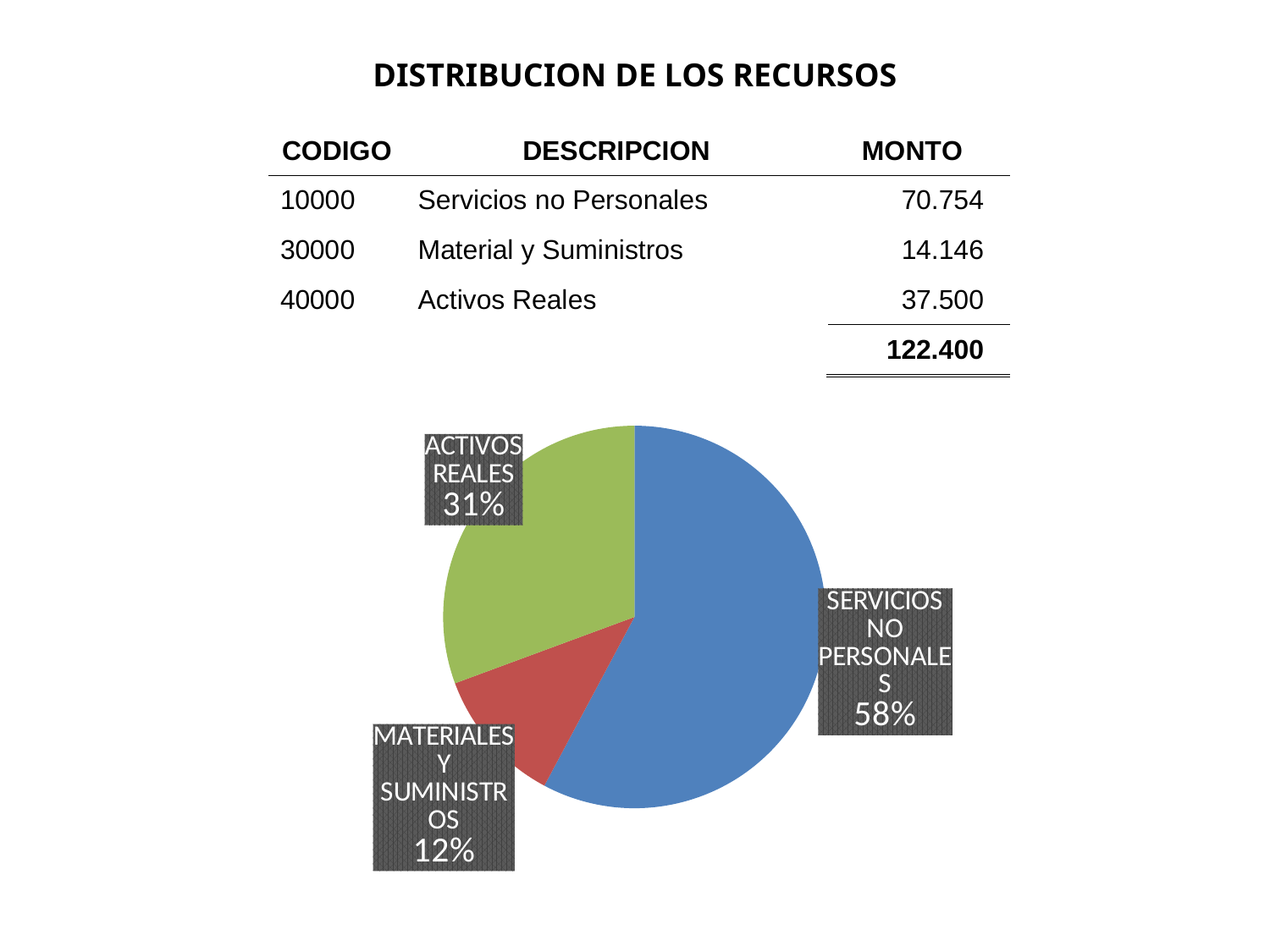
What colour is the SERVICIOS NO PERSONALES slice? blue What share of the pie does SERVICIOS NO PERSONALES represent? 58% Which slice is larger, ACTIVOS REALES or MATERIALES Y SUMINISTROS? ACTIVOS REALES What share of the pie does MATERIALES Y SUMINISTROS represent? 12% What is the difference in percentage points between the ACTIVOS REALES slice and the MATERIALES Y SUMINISTROS slice? 19 How many slices does the pie chart have? 3 What colour is the ACTIVOS REALES slice? green Which slice of the pie chart is the smallest? MATERIALES Y SUMINISTROS Which slice of the pie chart is the largest? SERVICIOS NO PERSONALES What kind of chart is shown on the slide? pie chart What share of the pie does ACTIVOS REALES represent? 31% What is the difference in percentage points between the SERVICIOS NO PERSONALES slice and the ACTIVOS REALES slice? 27